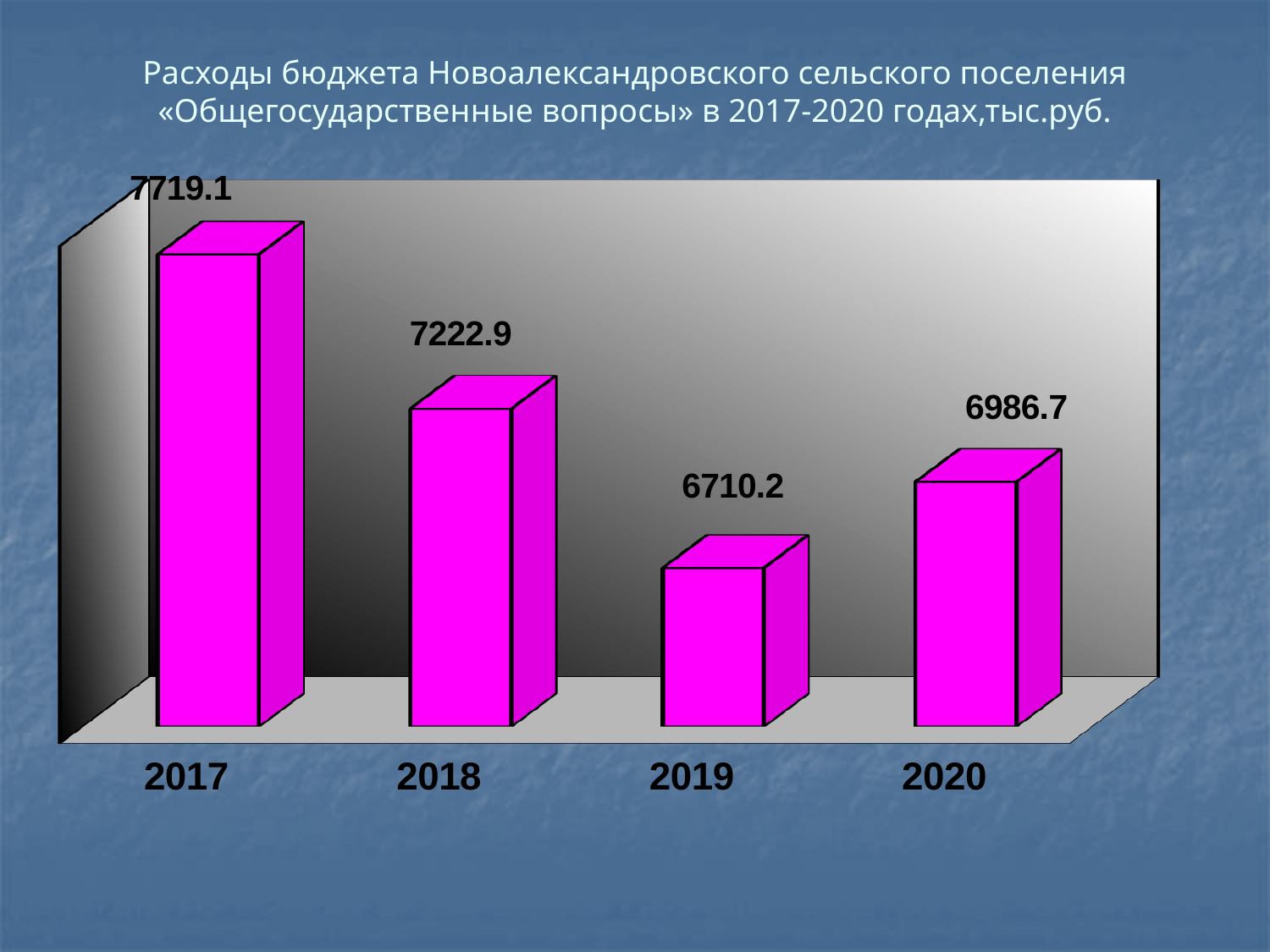
What is the difference between the values for 2020 and 2019? 276.5 Which year has the lowest value? 2019 What is the value for 2019? 6710.2 What is the value for 2020? 6986.7 What is the value for 2017? 7719.1 Which year has the highest value? 2017 What kind of chart is shown on the slide? Bar chart Which is larger, the value for 2018 or the value for 2020? 2018 Do the values rise or fall from 2017 to 2019? Fall What is the value for 2018? 7222.9 How many years are shown on the chart? 4 What is the difference between the values for 2017 and 2018? 496.2